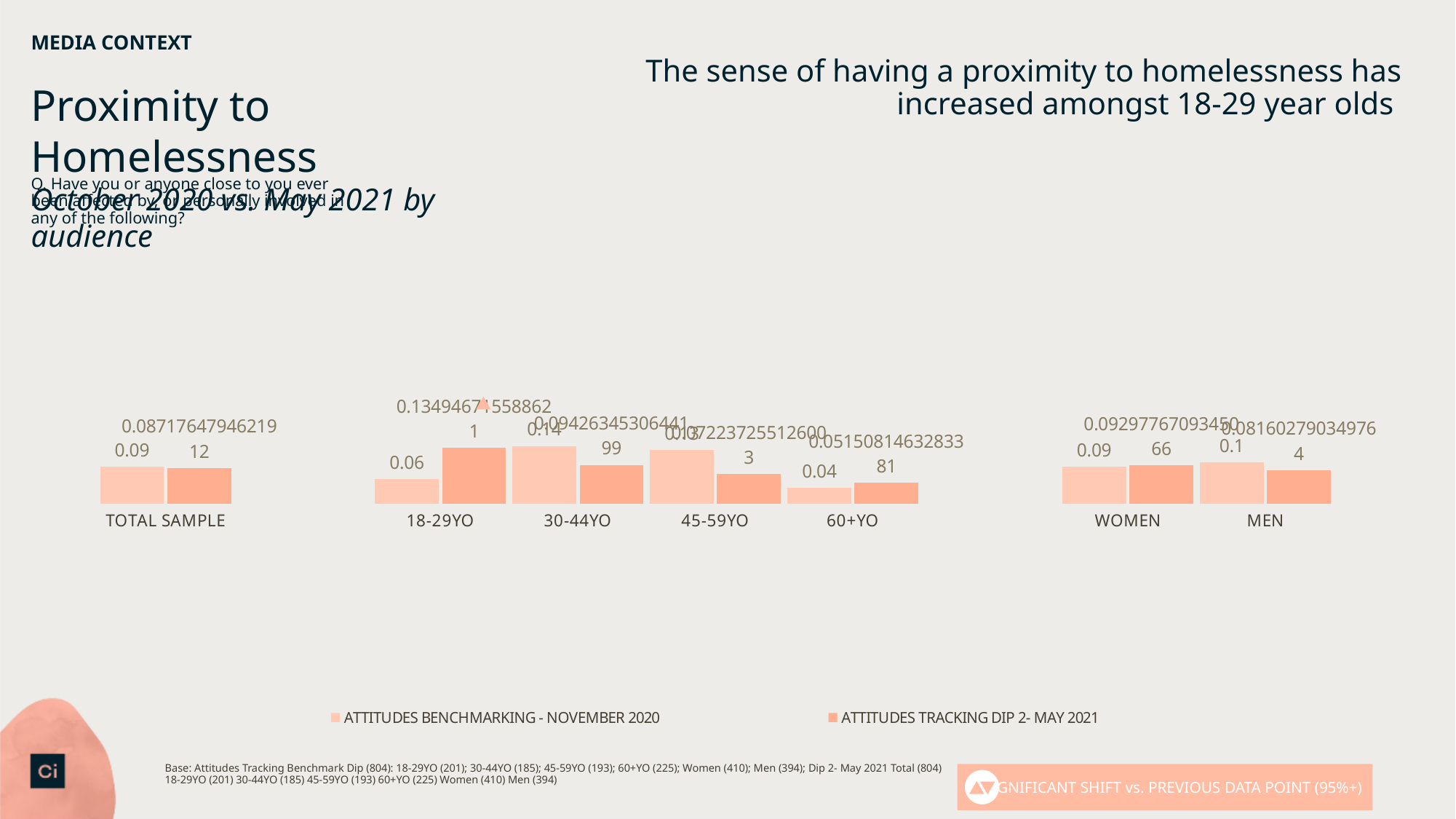
Which category has the lowest ATTITUDES BENCHMARKING - NOVEMBER 2020 value? 60+YO What is the ATTITUDES BENCHMARKING - NOVEMBER 2020 value for 30-44YO? 0.14 What is the ATTITUDES BENCHMARKING - NOVEMBER 2020 value for 18-29YO? 0.06 How many series does the chart legend list? 2 What is the ATTITUDES BENCHMARKING - NOVEMBER 2020 value for MEN? 0.1 What is the difference between the ATTITUDES BENCHMARKING - NOVEMBER 2020 values for 30-44YO and 18-29YO? 0.08 Which category has the highest ATTITUDES BENCHMARKING - NOVEMBER 2020 value? 30-44YO What are the two series named in the chart legend? ATTITUDES BENCHMARKING - NOVEMBER 2020 and ATTITUDES TRACKING DIP 2- MAY 2021 What kind of chart is shown on the slide? bar chart For 18-29YO, which series has the larger value? ATTITUDES TRACKING DIP 2- MAY 2021 What is the ATTITUDES BENCHMARKING - NOVEMBER 2020 value for 60+YO? 0.04 How many audience categories are shown along the x axis of the chart? 7